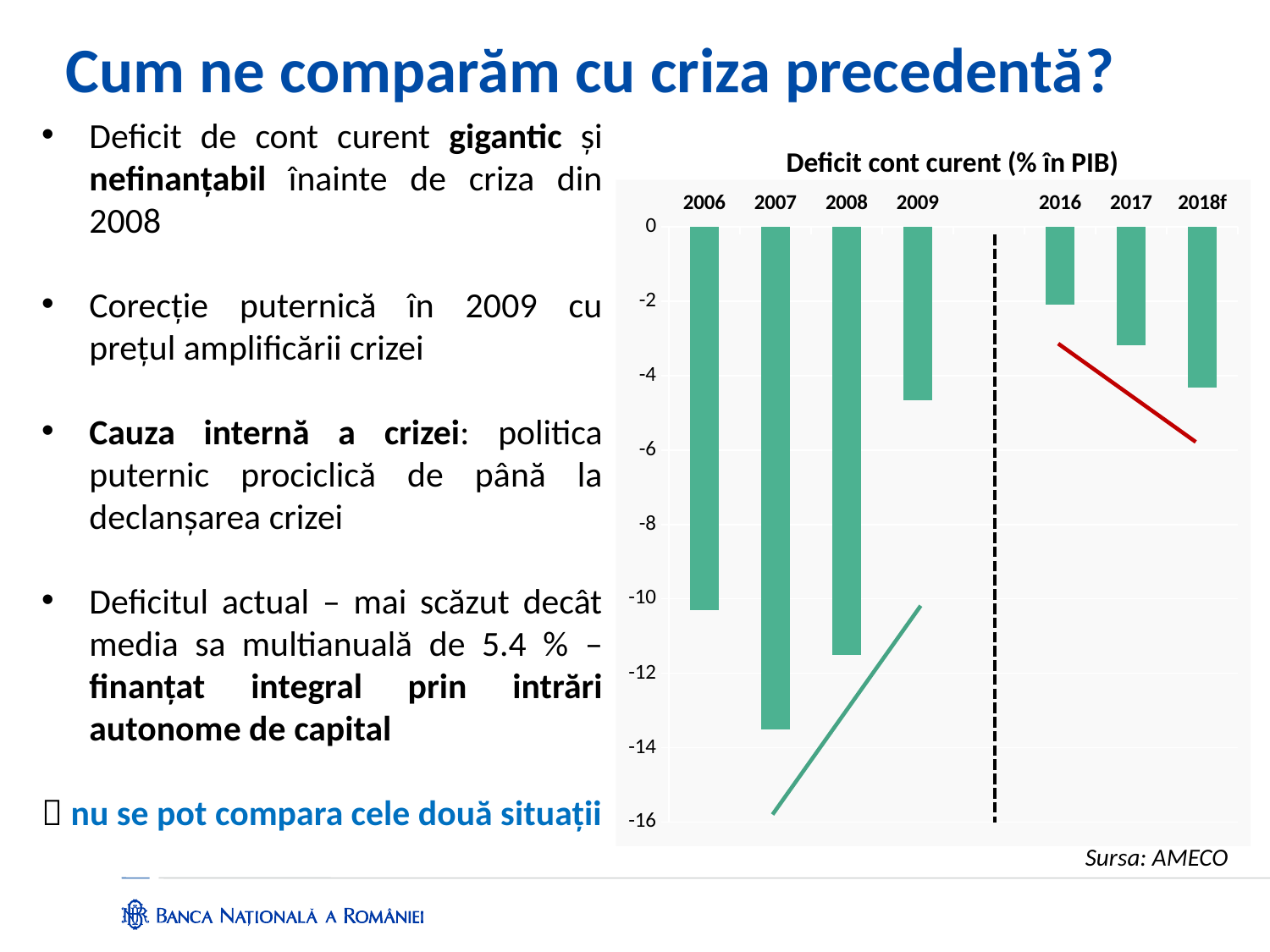
Is the value for 2008 greater or less than -10? less Which year shows a larger deficit, 2017 or 2018f? 2018f Is the value for 2016 greater or less than -4? greater What type of chart is shown on the slide? bar chart Which year has the largest current account deficit (the most negative bar)? 2007 What is the title of the chart? Deficit cont curent (% în PIB) Is the value for 2007 greater or less than -12? less What is the data source cited below the chart? AMECO Do the values fall or rise from 2016 to 2018f (does the deficit widen or narrow)? fall (the deficit widens) Which year has the smallest current account deficit (the bar closest to zero)? 2016 How many years (bars) are plotted in the chart? 7